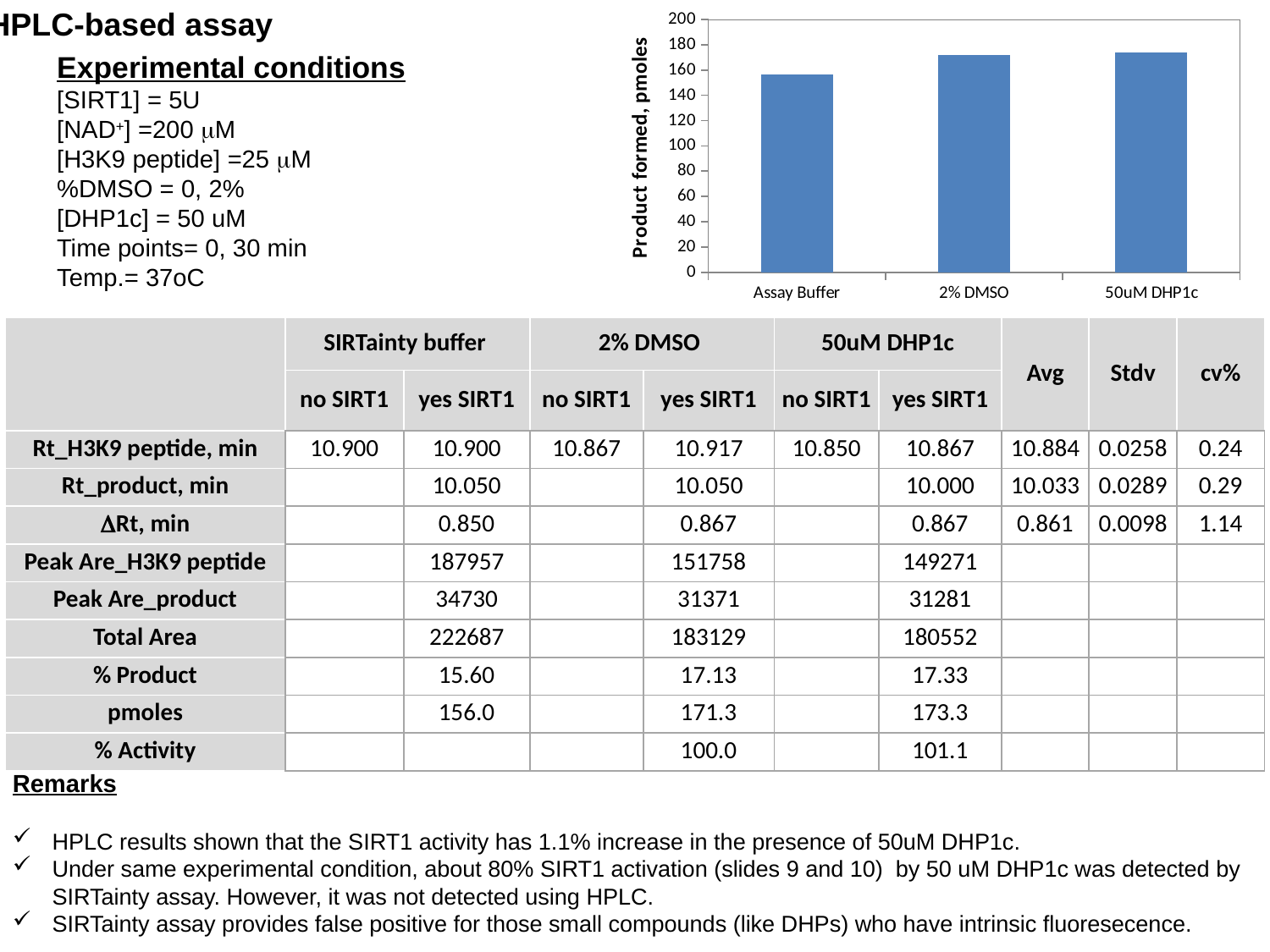
What is the title of the y axis of the chart? Product formed, pmoles Is the bar for Assay Buffer greater or less than 140? greater Which category has the lowest bar in the chart? Assay Buffer What is the maximum value shown on the y axis of the chart? 200 How many categories are plotted on the x axis of the chart? 3 Is the bar for 50uM DHP1c greater or less than 160? greater Do the bar values rise or fall from left to right across the chart? rise Is the bar for 2% DMSO greater or less than 160? greater Which is larger in the chart, the bar for Assay Buffer or the bar for 50uM DHP1c? 50uM DHP1c What kind of chart is shown on the slide? bar chart Which is larger in the chart, the bar for Assay Buffer or the bar for 2% DMSO? 2% DMSO